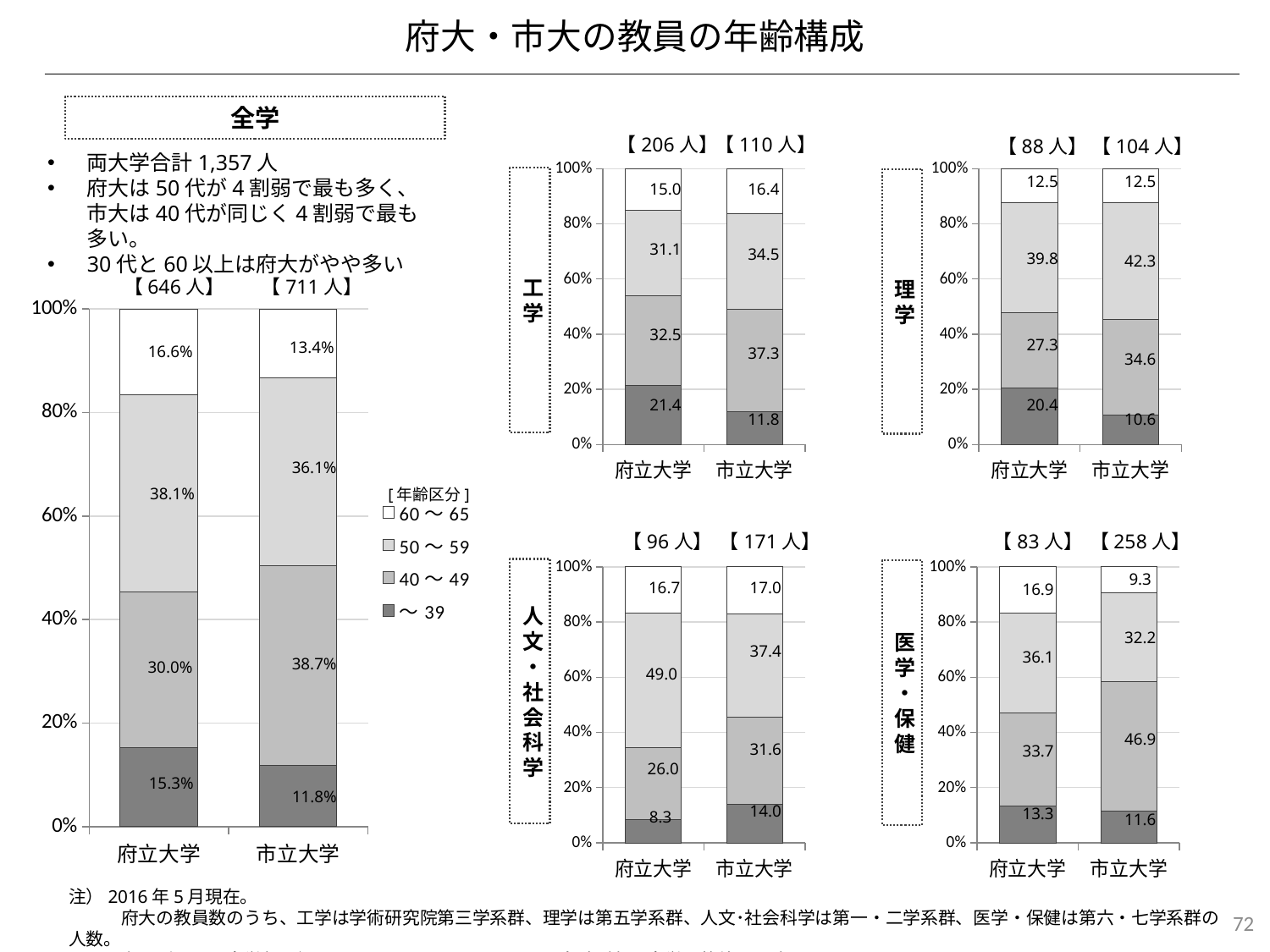
In the 人文・社会科学 chart, what is the value of the 50～59 segment for 府立大学? 49.0 In the 工学 chart, which bar has the larger ～39 segment, 府立大学 or 市立大学? 府立大学 In the 全学 chart, what is the difference between the 60～65 values for 府立大学 and 市立大学? 3.2% How many series does the legend of the 全学 chart list? 4 In the 医学・保健 chart, what is the value of the 40～49 segment for 市立大学? 46.9 In the 全学 chart, what is the value of the 40～49 segment for 市立大学? 38.7% In the 全学 chart, what is the value of the 50～59 segment for 府立大学? 38.1% In the 人文・社会科学 chart, which segment is the smallest for 府立大学? ～39 In the 医学・保健 chart, which segment is the largest for 市立大学? 40～49 In the 工学 chart, what is the value of the ～39 segment for 府立大学? 21.4 In the 理学 chart, what is the value of the 50～59 segment for 市立大学? 42.3 What kind of chart is the 理学 chart? Stacked bar chart